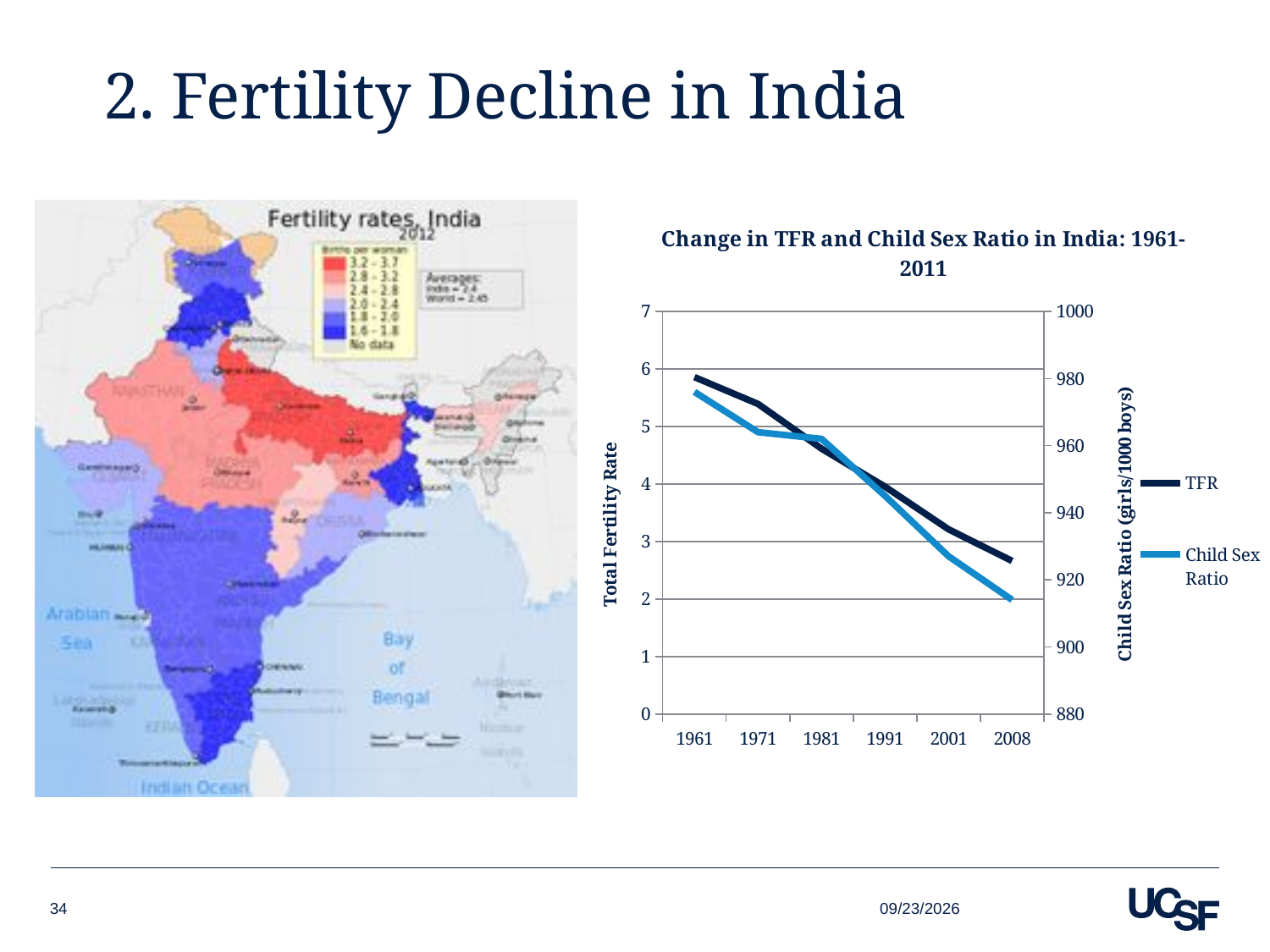
How many series does the legend of the 'Change in TFR and Child Sex Ratio in India' chart list? 2 In the 'Change in TFR and Child Sex Ratio in India' chart, does the Child Sex Ratio line rise or fall from 1961 to 2008? fall In the 'Change in TFR and Child Sex Ratio in India' chart, does the TFR line rise or fall from 1961 to 2008? fall In the 'Change in TFR and Child Sex Ratio in India' chart, is the TFR value for 2008 greater or less than 3? less Which series in the 'Change in TFR and Child Sex Ratio in India' chart is drawn in the lighter blue line? Child Sex Ratio In the 'Change in TFR and Child Sex Ratio in India' chart, which year has the higher TFR, 1961 or 2008? 1961 What kind of chart is 'Change in TFR and Child Sex Ratio in India: 1961-2011'? line chart In the 'Change in TFR and Child Sex Ratio in India' chart, is the Child Sex Ratio value for 1961 greater or less than 960? greater In the 'Change in TFR and Child Sex Ratio in India' chart, how many years are marked on the x axis? 6 In the 'Change in TFR and Child Sex Ratio in India' chart, is the TFR value for 1961 greater or less than 5? greater What is the label of the right-hand vertical axis in the 'Change in TFR and Child Sex Ratio in India' chart? Child Sex Ratio (girls/1000 boys)